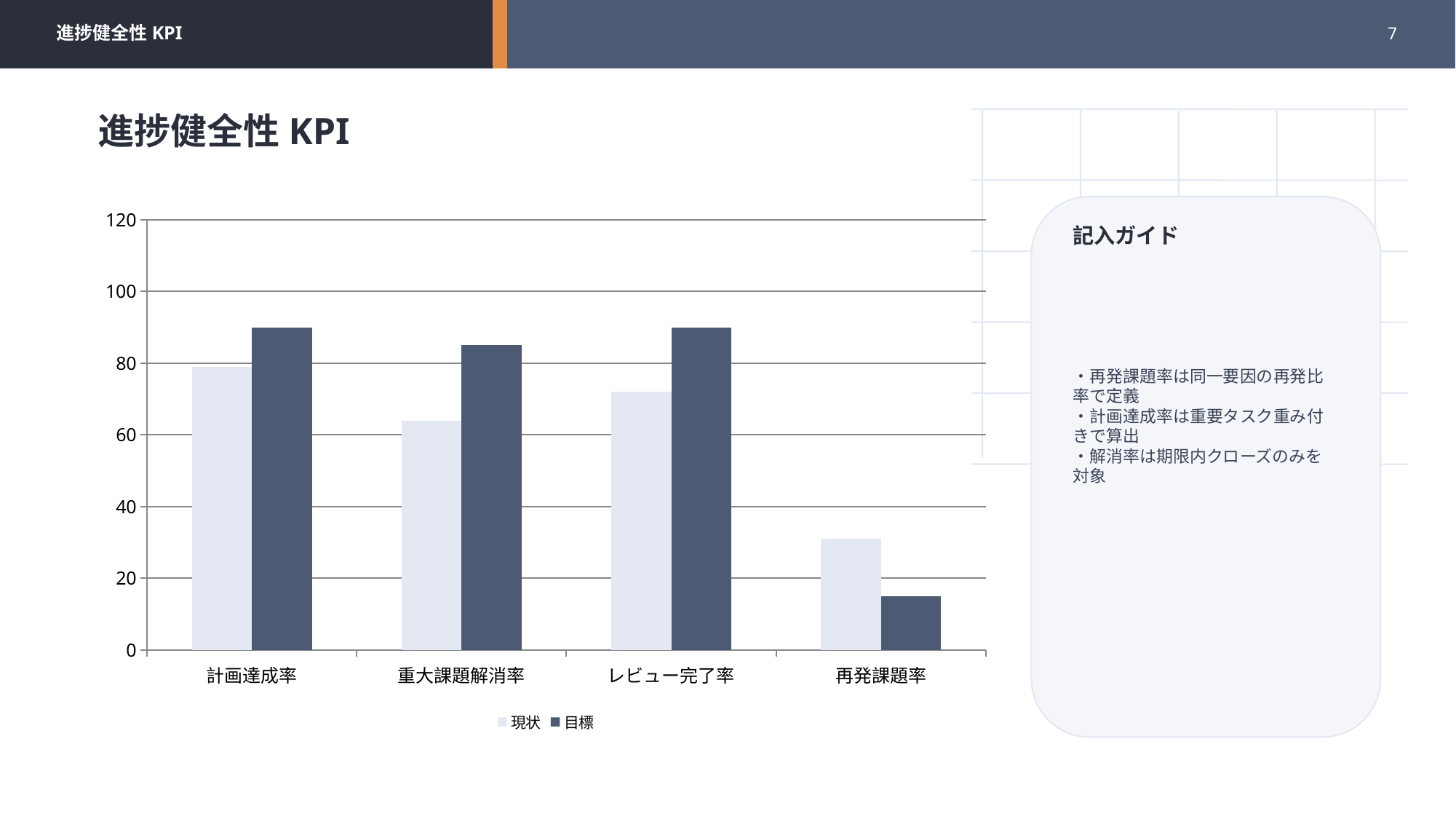
Which category has the highest 現状 value? 計画達成率 Is the 現状 value for 重大課題解消率 greater or less than 60? greater Which category has the lowest 目標 value? 再発課題率 For 再発課題率, which is larger, the 現状 value or the 目標 value? 現状 How many series does the chart legend list? 2 Which category has the lowest 現状 value? 再発課題率 Is the 目標 value for 再発課題率 greater or less than 20? less What kind of chart is shown on the slide? bar chart Is the 目標 value for 計画達成率 greater or less than 100? less How many categories are shown on the x axis of the chart? 4 What are the two series named in the chart legend? 現状, 目標 For レビュー完了率, which is larger, the 現状 value or the 目標 value? 目標